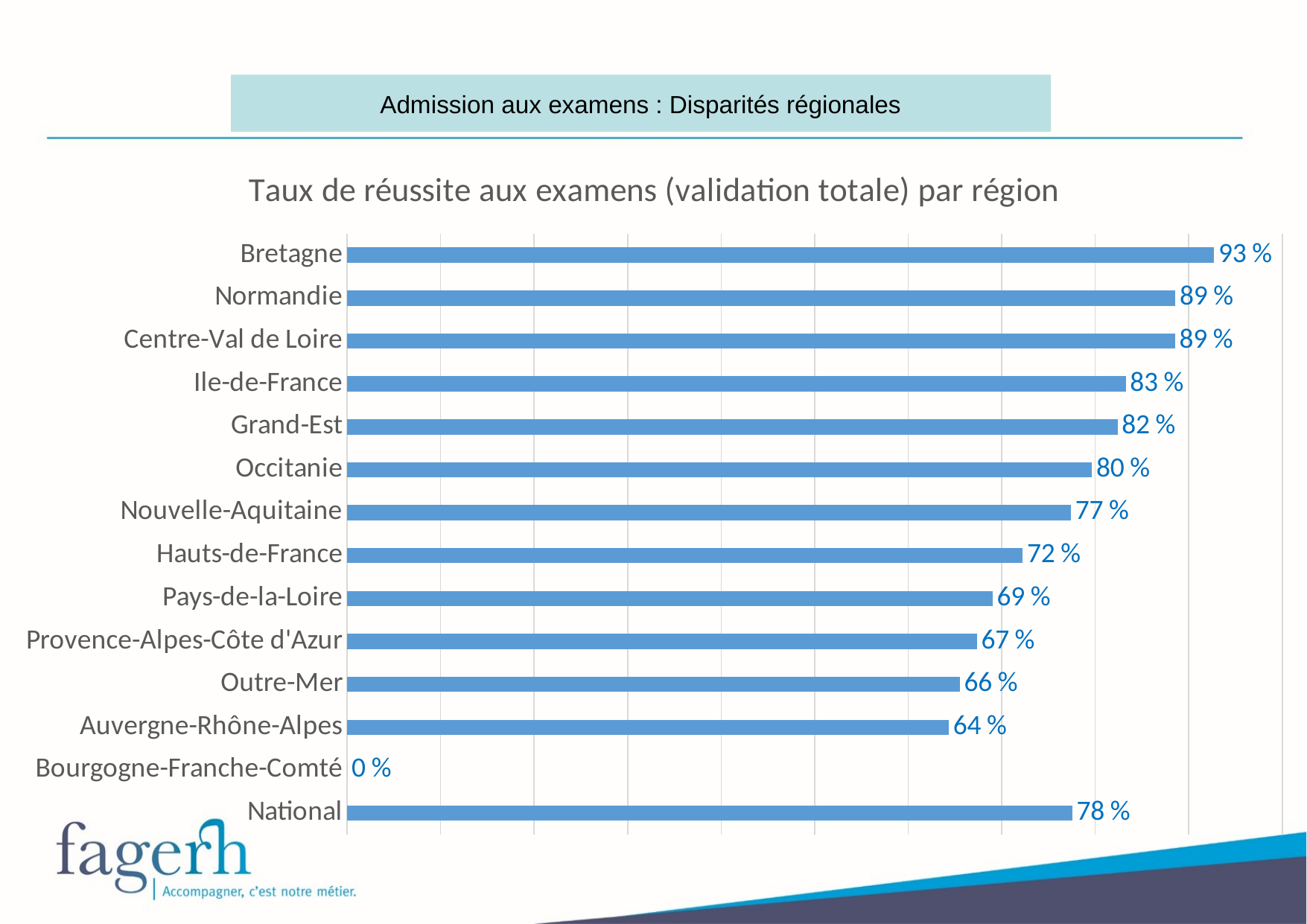
What is the exam success rate for Bretagne? 93 % Which category has the lowest value on the chart? Bourgogne-Franche-Comté What is the exam success rate for Outre-Mer? 66 % Which has a higher success rate, Occitanie or Nouvelle-Aquitaine? Occitanie What kind of chart is shown on the slide? Bar chart What is the difference between the success rates of Bretagne and Auvergne-Rhône-Alpes? 29 % Which region has the highest exam success rate? Bretagne What is the value shown for National? 78 % How many categories are shown on the chart? 14 What is the title of the chart? Taux de réussite aux examens (validation totale) par région What is the difference between the National rate and the rate for Pays-de-la-Loire? 9 % What is the exam success rate for Hauts-de-France? 72 %